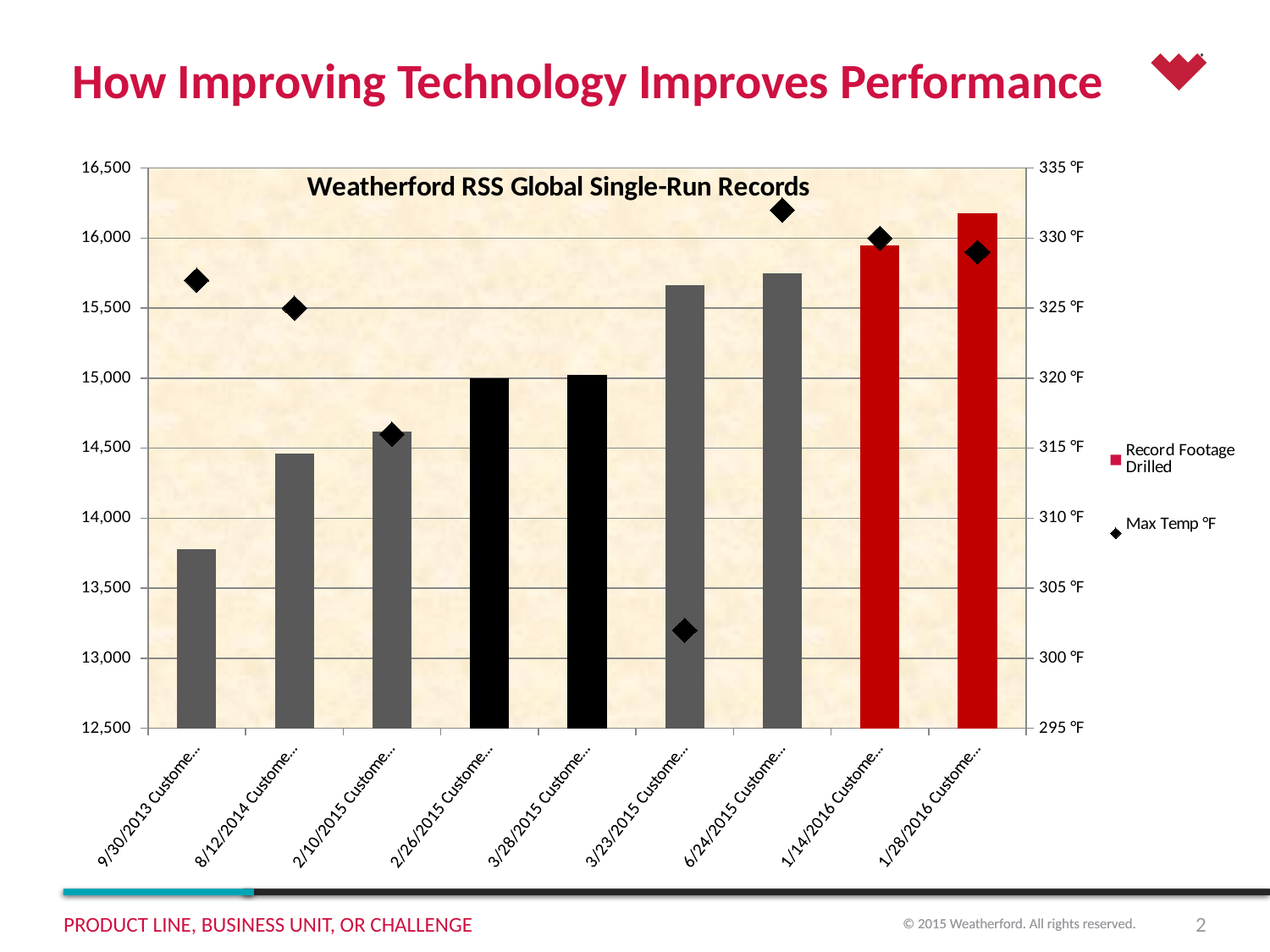
Which category has the lowest Record Footage Drilled bar? 9/30/2013 Custome... Which has the larger Record Footage Drilled, 6/24/2015 or 1/14/2016? 1/14/2016 How many categories are shown along the x axis of the chart? 9 What is the title of the chart? Weatherford RSS Global Single-Run Records Which category has the lowest Max Temp °F marker? 3/23/2015 Custome... Is the Max Temp °F for 3/23/2015 greater or less than 305 °F? less Is the Record Footage Drilled for 9/30/2013 greater or less than 14,000? less Which category has the highest Record Footage Drilled bar? 1/28/2016 Custome... How many series does the chart legend list? 2 What kind of chart is used to show Record Footage Drilled? bar chart Do the Record Footage Drilled bars generally rise or fall from left to right along the x axis? rise Is the Record Footage Drilled for 1/28/2016 greater or less than 16,000? greater